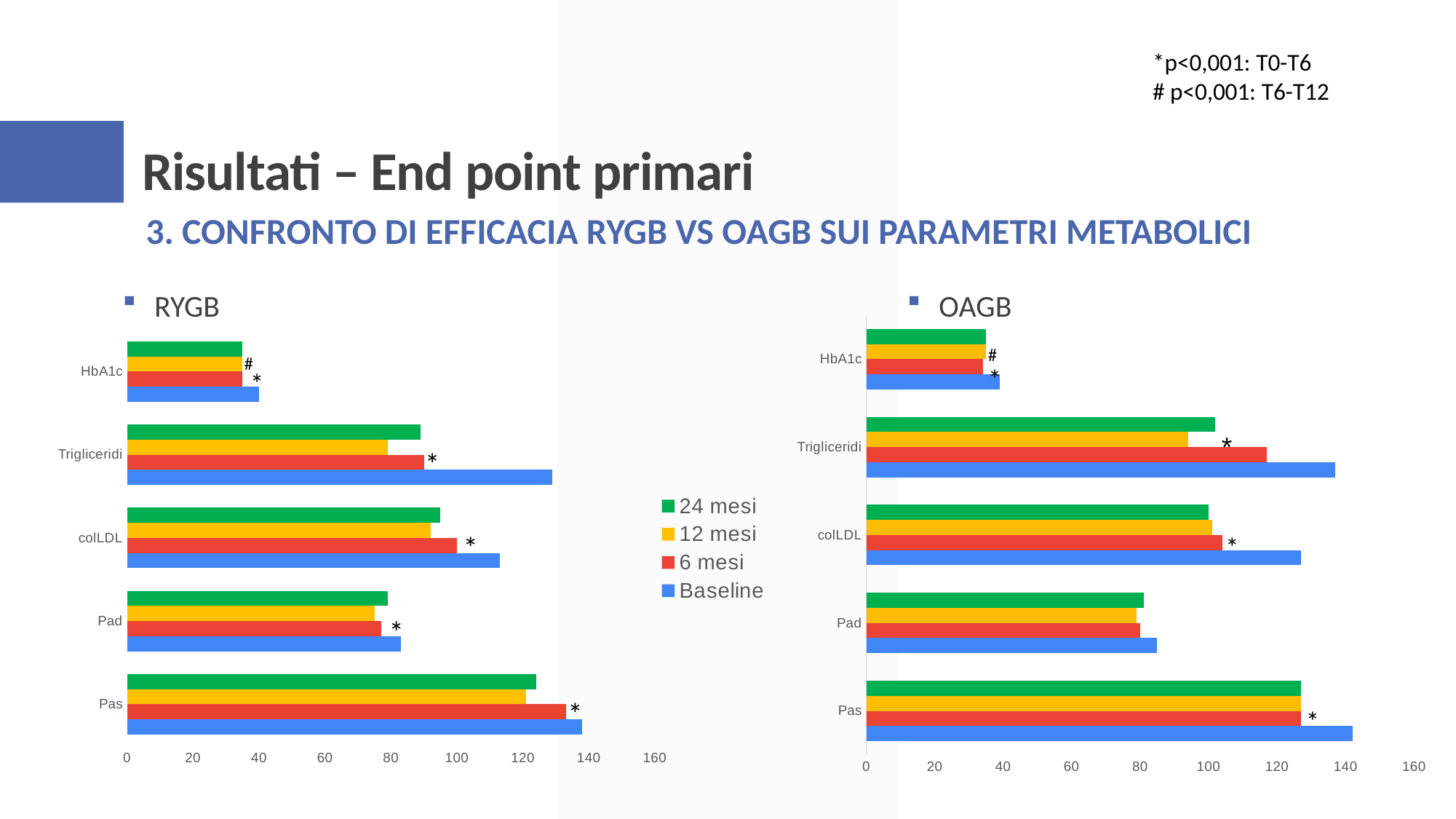
In the RYGB chart, is the 6 mesi value for Pad greater or less than 80? less In the OAGB chart, which is larger for colLDL: the Baseline value or the 12 mesi value? Baseline How many series does the legend list? 4 Which legend entry is shown in green? 24 mesi In the RYGB chart, which category has the highest Baseline value? Pas In the OAGB chart, is the 24 mesi value for HbA1c greater or less than 40? less In the OAGB chart, is the Baseline value for Trigliceridi greater or less than 120? greater How many categories are shown on the OAGB chart? 5 In the OAGB chart, which category has the lowest Baseline value? HbA1c What kind of chart is the RYGB chart on the left? bar chart In the RYGB chart, which is larger for Trigliceridi: the Baseline value or the 24 mesi value? Baseline